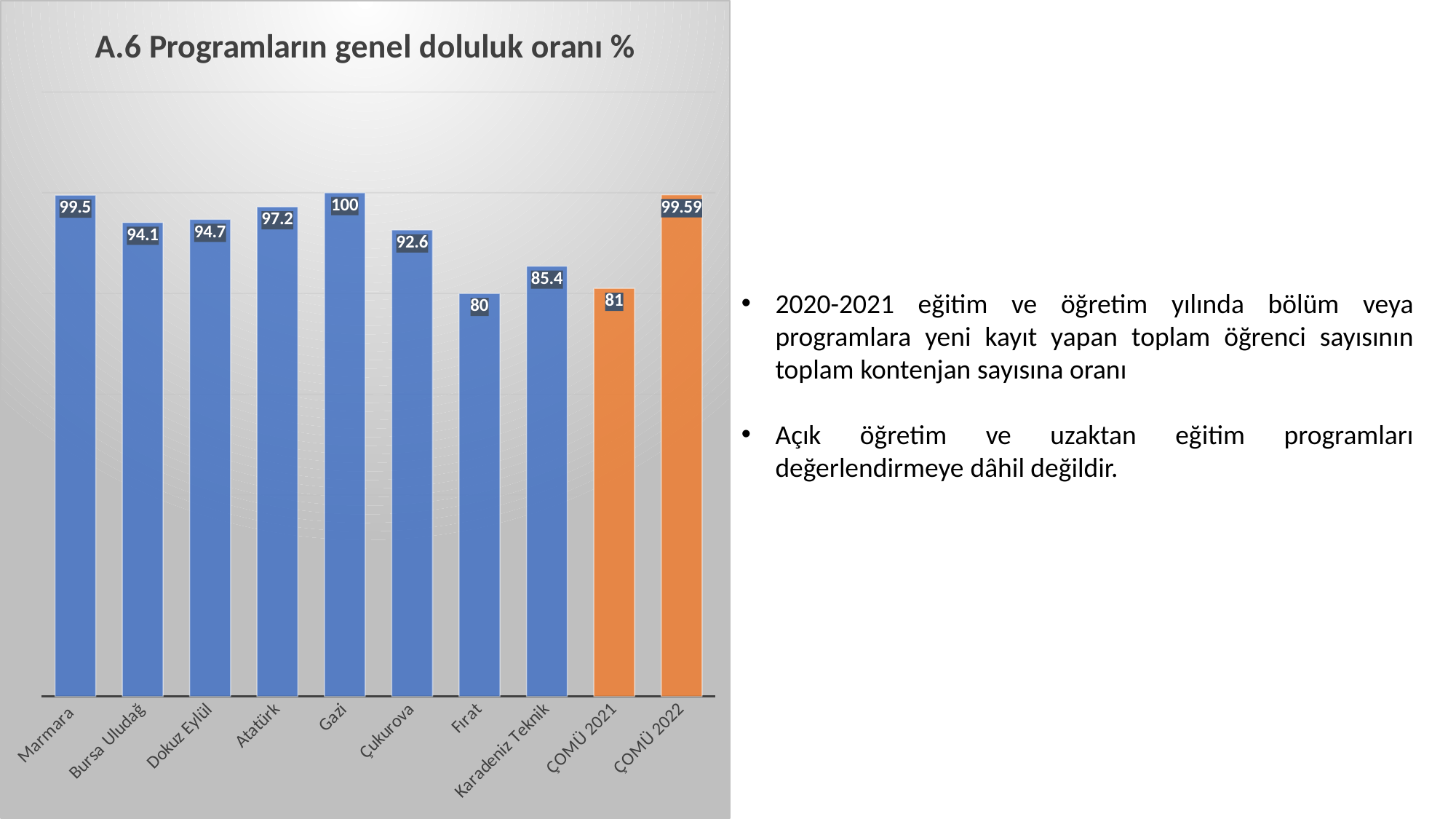
What kind of chart is shown on the slide? Bar chart What is the value for Gazi? 100 What is the value for Karadeniz Teknik? 85.4 What is the title of the chart? A.6 Programların genel doluluk oranı % What is the difference between the values for Gazi and Fırat? 20 Which category has the highest value? Gazi Which category has the lowest value? Fırat What is the value for ÇOMÜ 2022? 99.59 How many categories are shown on the x axis? 10 What is the difference between the values for ÇOMÜ 2022 and ÇOMÜ 2021? 18.59 Which is larger, the value for Atatürk or the value for Dokuz Eylül? Atatürk What is the value for Bursa Uludağ? 94.1